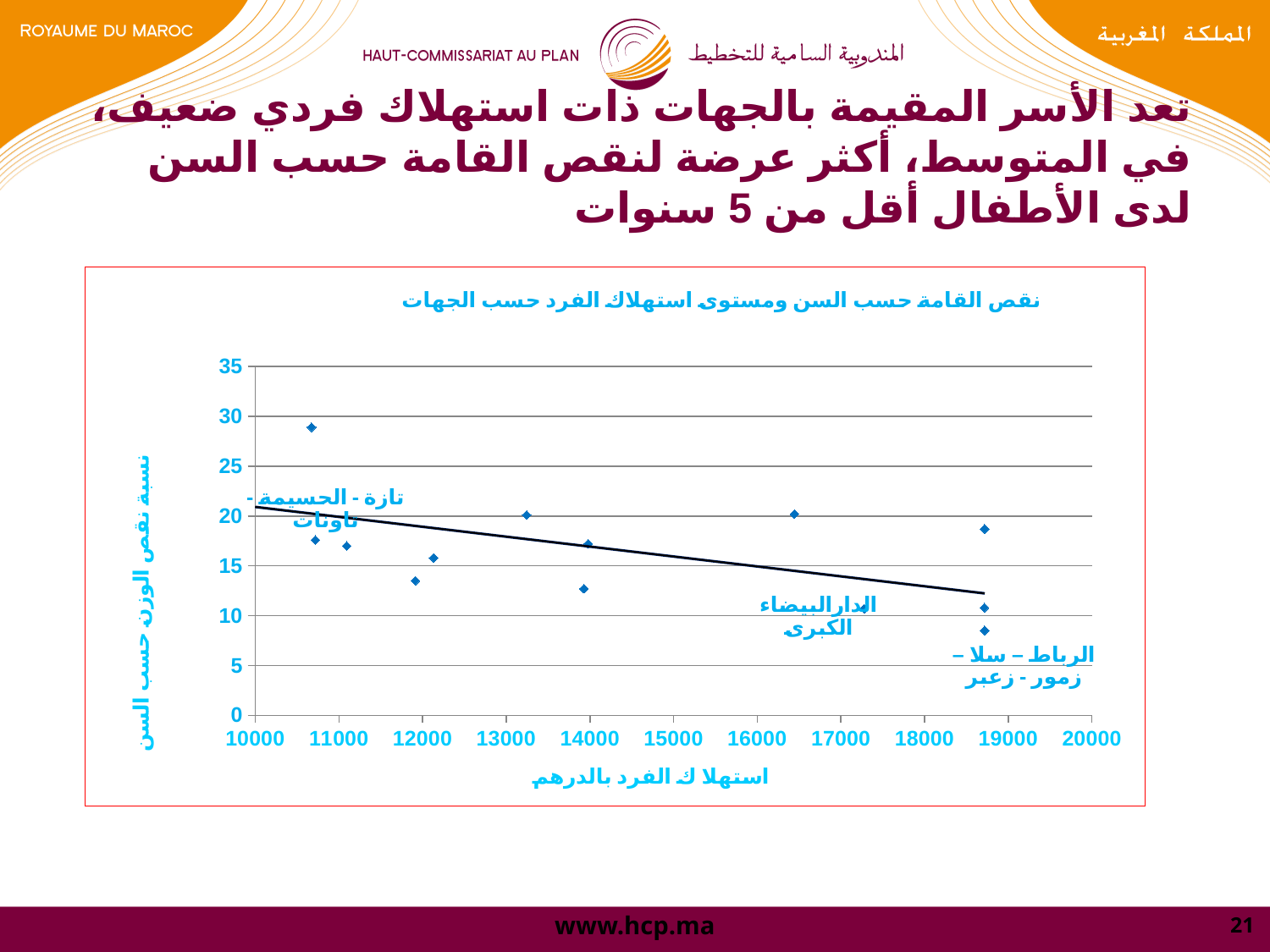
Is the per-capita consumption of the highest plotted point greater or less than 12000? less Is the lowest plotted point's stunting rate greater or less than 10? less Which has the higher stunting rate: the highest point near 10700 dirhams or the point near 16400 dirhams? the point near 10700 dirhams Is the per-capita consumption of the lowest plotted point greater or less than 18000? greater What is the title of the chart? نقص القامة حسب السن ومستوى استهلاك الفرد حسب الجهات What is the maximum value shown on the vertical axis? 35 What is the label of the horizontal axis of the chart? استهلاك الفرد بالدرهم Does the fitted trend line rise or fall as per-capita consumption increases along the x axis? falls What kind of chart is shown on the slide? scatter chart